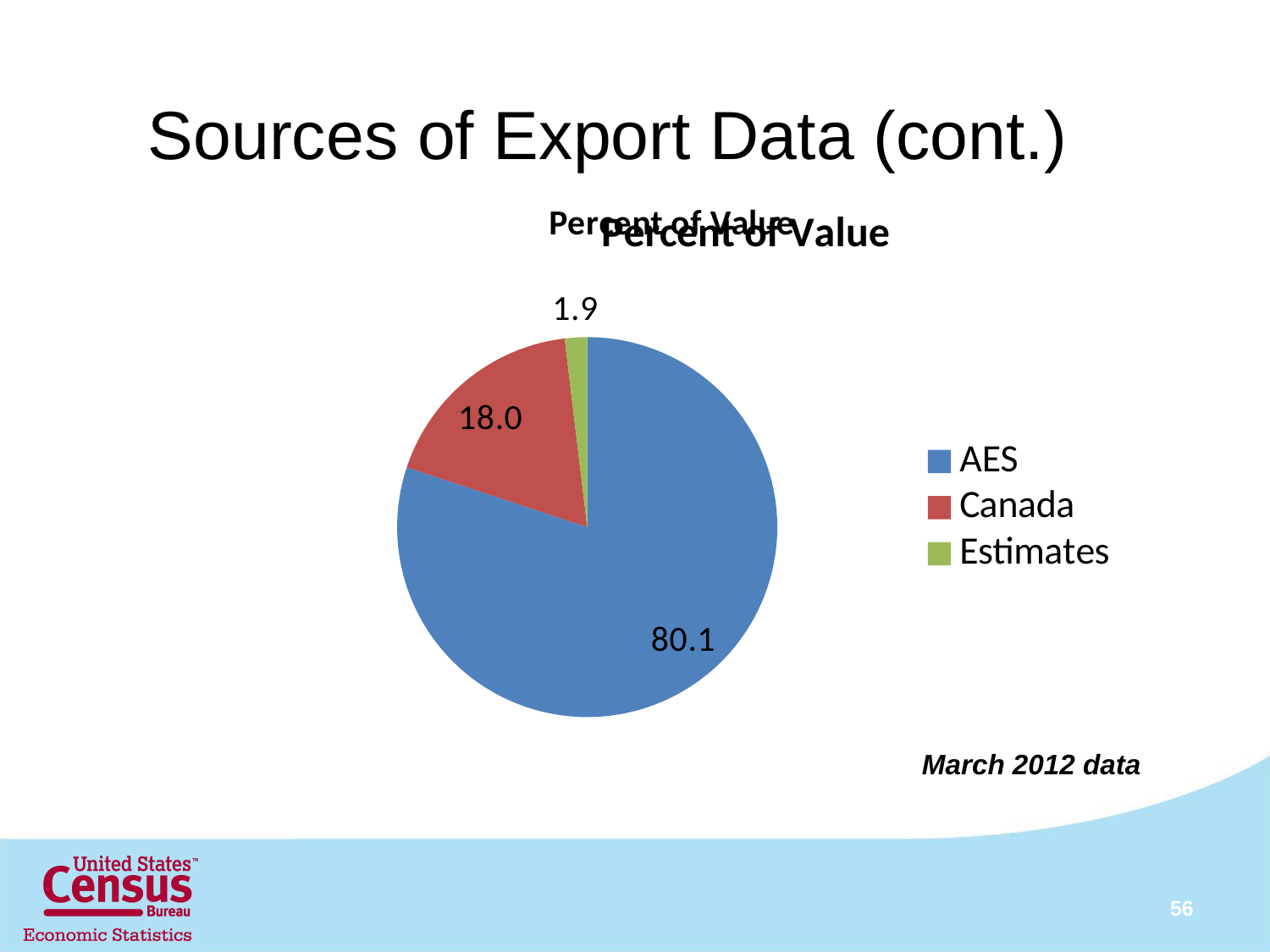
What is the value for Canada in the pie chart? 18.0 What is the title of the pie chart? Percent of Value Which colour represents Canada in the pie chart? red Which category has the largest slice of the pie? AES What is the difference between the values for AES and Canada? 62.1 What is the difference between the values for Canada and Estimates? 16.1 How many categories does the pie chart show? 3 What kind of chart is shown on the slide? pie chart Which category has the smallest slice of the pie? Estimates Which is larger, the value for Canada or the value for Estimates? Canada What is the value for AES in the pie chart? 80.1 What is the value for Estimates in the pie chart? 1.9